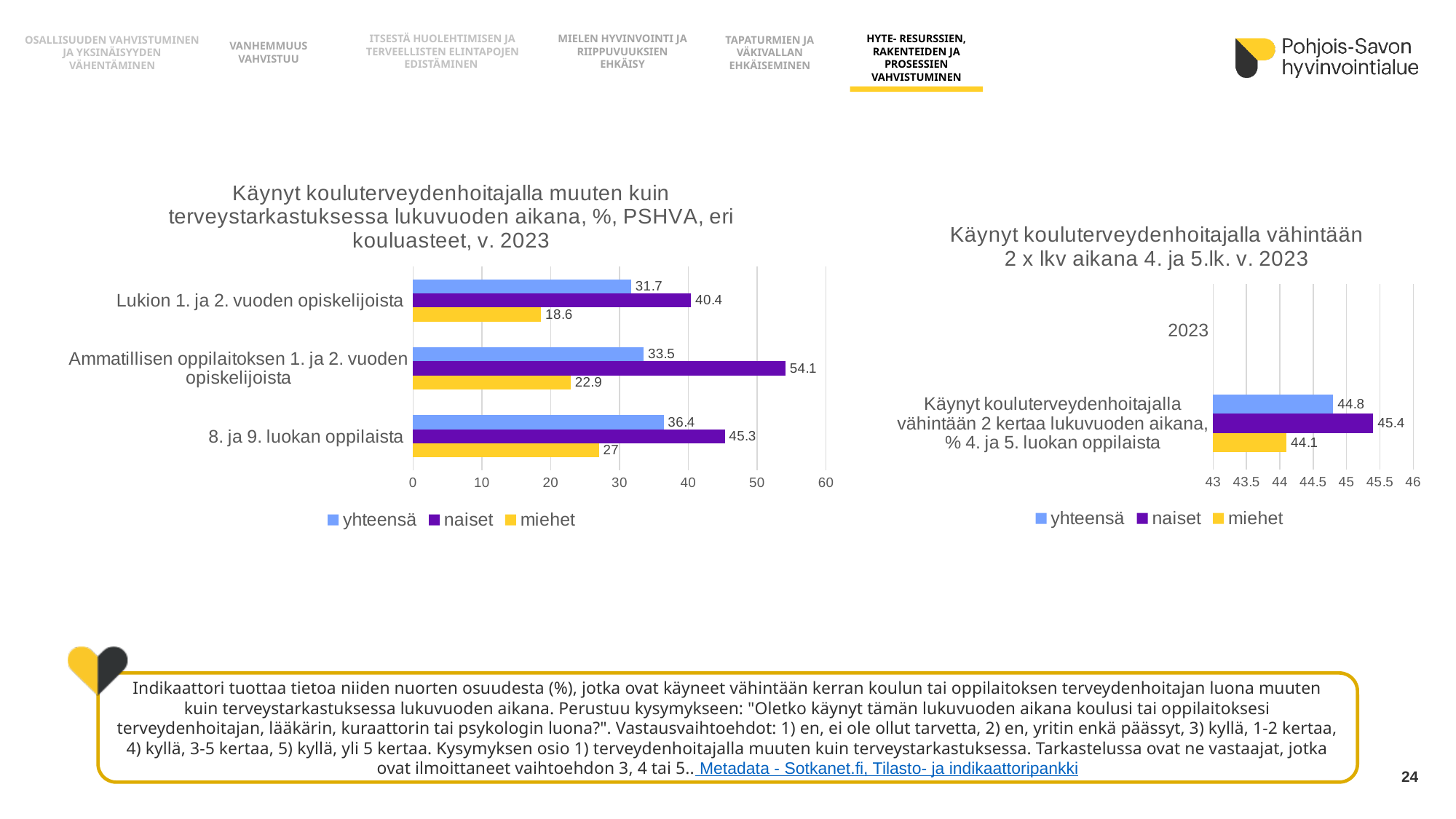
In the right chart (Käynyt kouluterveydenhoitajalla vähintään 2 x lkv aikana), what is the value for naiset? 45.4 In the left chart (Käynyt kouluterveydenhoitajalla muuten kuin terveystarkastuksessa), which is larger: the yhteensä value for Lukion 1. ja 2. vuoden opiskelijoista or for Ammatillisen oppilaitoksen 1. ja 2. vuoden opiskelijoista? Ammatillisen oppilaitoksen 1. ja 2. vuoden opiskelijoista How many categories are shown on the left chart (Käynyt kouluterveydenhoitajalla muuten kuin terveystarkastuksessa)? 3 How many series does the legend of the right chart (Käynyt kouluterveydenhoitajalla vähintään 2 x lkv aikana) list? 3 In the left chart (Käynyt kouluterveydenhoitajalla muuten kuin terveystarkastuksessa), which category has the highest naiset value? Ammatillisen oppilaitoksen 1. ja 2. vuoden opiskelijoista In the left chart (Käynyt kouluterveydenhoitajalla muuten kuin terveystarkastuksessa), which category has the lowest miehet value? Lukion 1. ja 2. vuoden opiskelijoista In the left chart (Käynyt kouluterveydenhoitajalla muuten kuin terveystarkastuksessa), what is the difference between the naiset and miehet values for 8. ja 9. luokan oppilaista? 18.3 In the left chart (Käynyt kouluterveydenhoitajalla muuten kuin terveystarkastuksessa), what is the yhteensä value for 8. ja 9. luokan oppilaista? 36.4 What kind of chart is the left chart (Käynyt kouluterveydenhoitajalla muuten kuin terveystarkastuksessa)? Bar chart In the left chart (Käynyt kouluterveydenhoitajalla muuten kuin terveystarkastuksessa), what is the value for naiset among Ammatillisen oppilaitoksen 1. ja 2. vuoden opiskelijoista? 54.1 In the left chart (Käynyt kouluterveydenhoitajalla muuten kuin terveystarkastuksessa), what is the value for miehet among Lukion 1. ja 2. vuoden opiskelijoista? 18.6 In the right chart (Käynyt kouluterveydenhoitajalla vähintään 2 x lkv aikana), what is the difference between the yhteensä and miehet values? 0.7